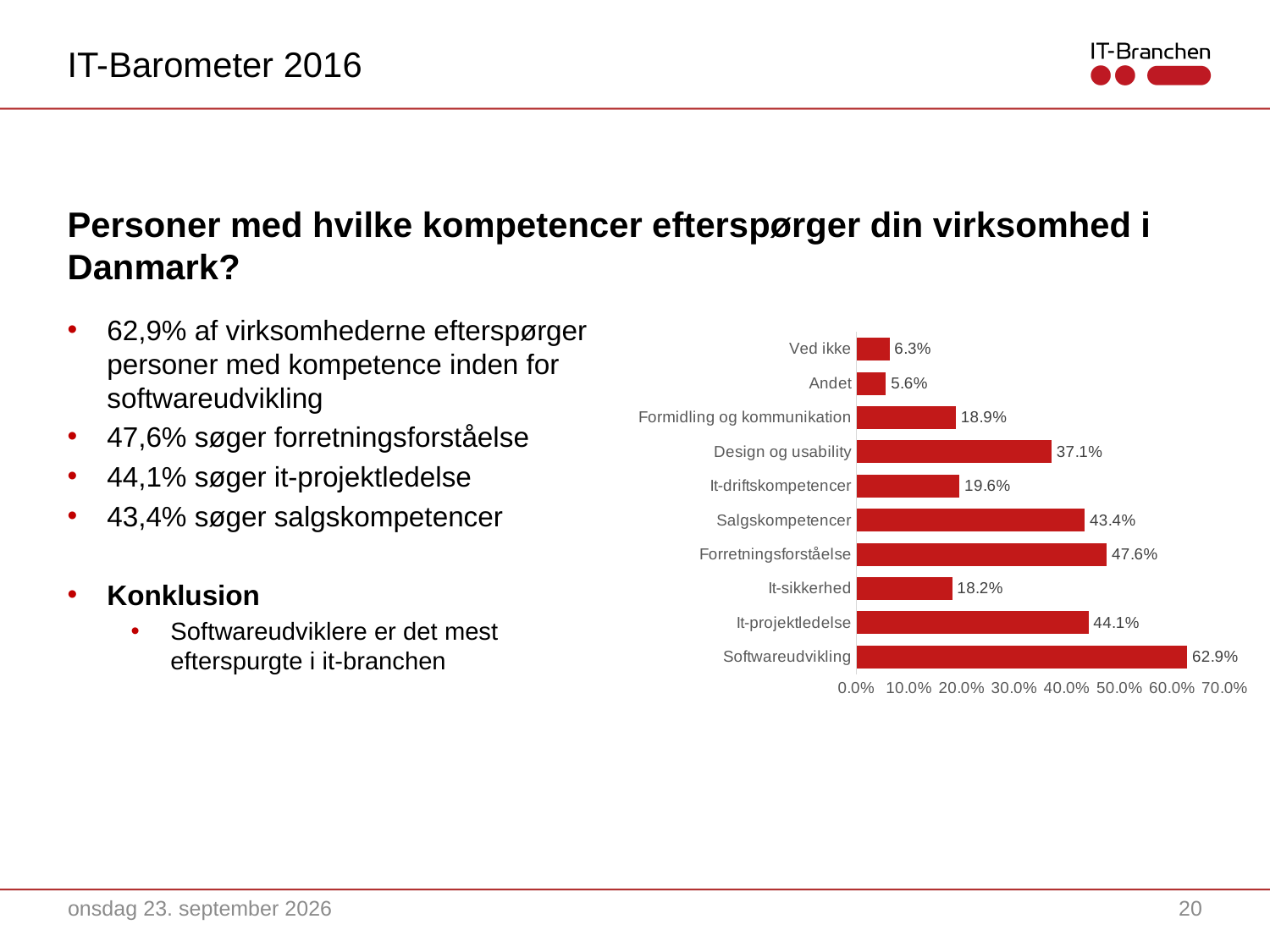
What colour are the bars in the chart? red Which is larger, It-projektledelse or Salgskompetencer? It-projektledelse What is the value for It-sikkerhed? 18.2% What is the value for Design og usability? 37.1% What is the value for Softwareudvikling? 62.9% How many categories are shown in the chart? 10 Which category has the lowest value? Andet What is the difference between It-driftskompetencer and Formidling og kommunikation? 0.7% Which category has the highest value? Softwareudvikling Is the value for Design og usability greater or less than 40.0%? less What is the difference between Softwareudvikling and Forretningsforståelse? 15.3% What kind of chart is shown on the slide? bar chart